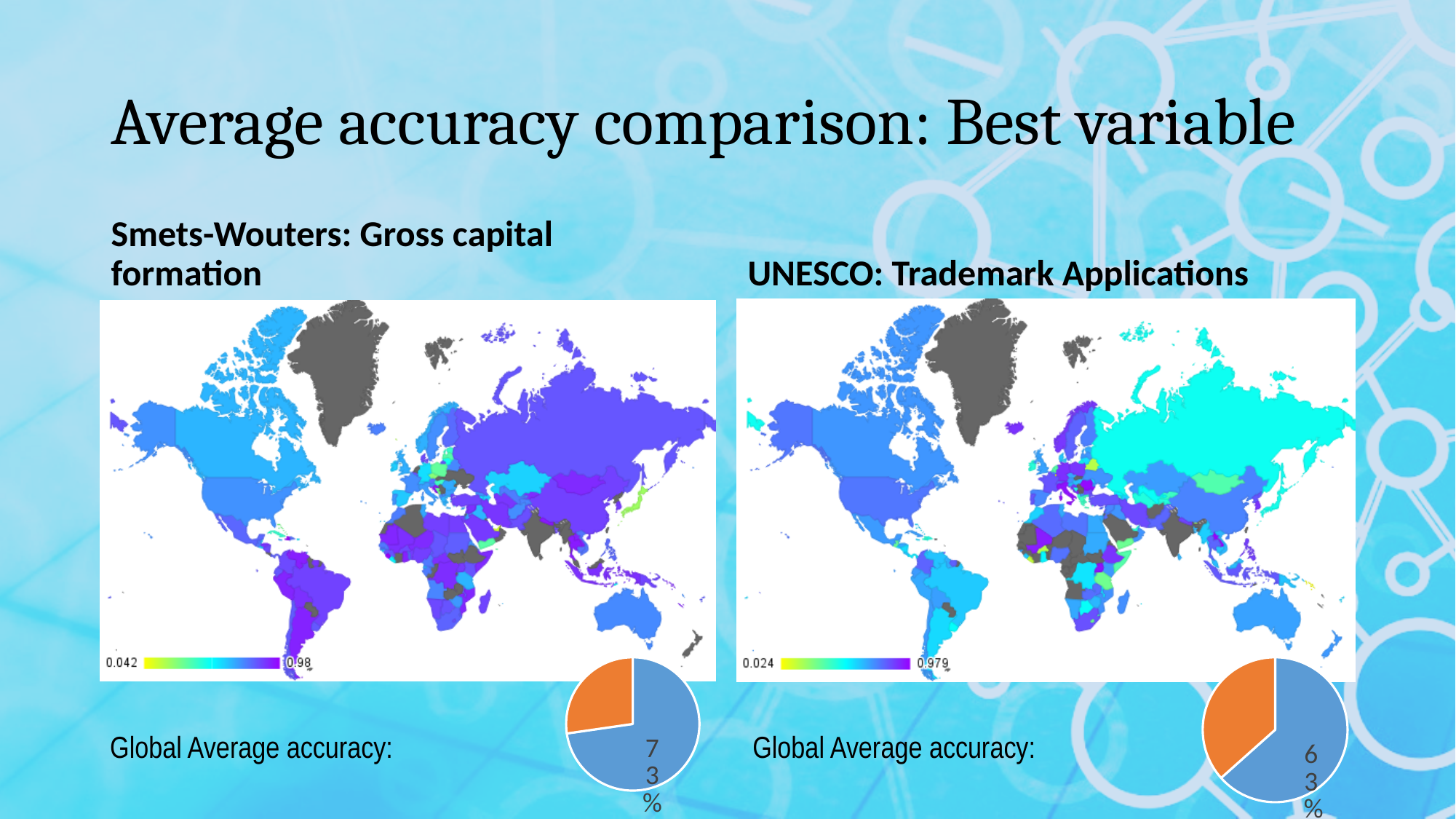
How many slices does the pie chart under the Smets-Wouters map have? 2 Which pie chart shows the higher global average accuracy, the one under the Smets-Wouters map or the one under the UNESCO map? Smets-Wouters What kind of chart is shown next to 'Global Average accuracy:' under the Smets-Wouters map? Pie chart In the pie chart under the Smets-Wouters: Gross capital formation map, what value is labelled on the blue slice? 73% How many slices does the pie chart under the UNESCO map have? 2 In the pie chart under the UNESCO map, is the orange slice larger or smaller than the blue slice? smaller What are the minimum and maximum values on the colour scale of the Smets-Wouters: Gross capital formation map? 0.042 and 0.98 In the pie chart under the UNESCO: Trademark Applications map, what value is labelled on the blue slice? 63% What are the minimum and maximum values on the colour scale of the UNESCO: Trademark Applications map? 0.024 and 0.979 What is the difference between the global average accuracy shown in the Smets-Wouters pie chart (73%) and the UNESCO pie chart (63%)? 10% In the pie chart under the Smets-Wouters map, which colour is the larger slice? Blue In the pie chart under the Smets-Wouters map, is the blue slice's value greater or less than 50%? greater